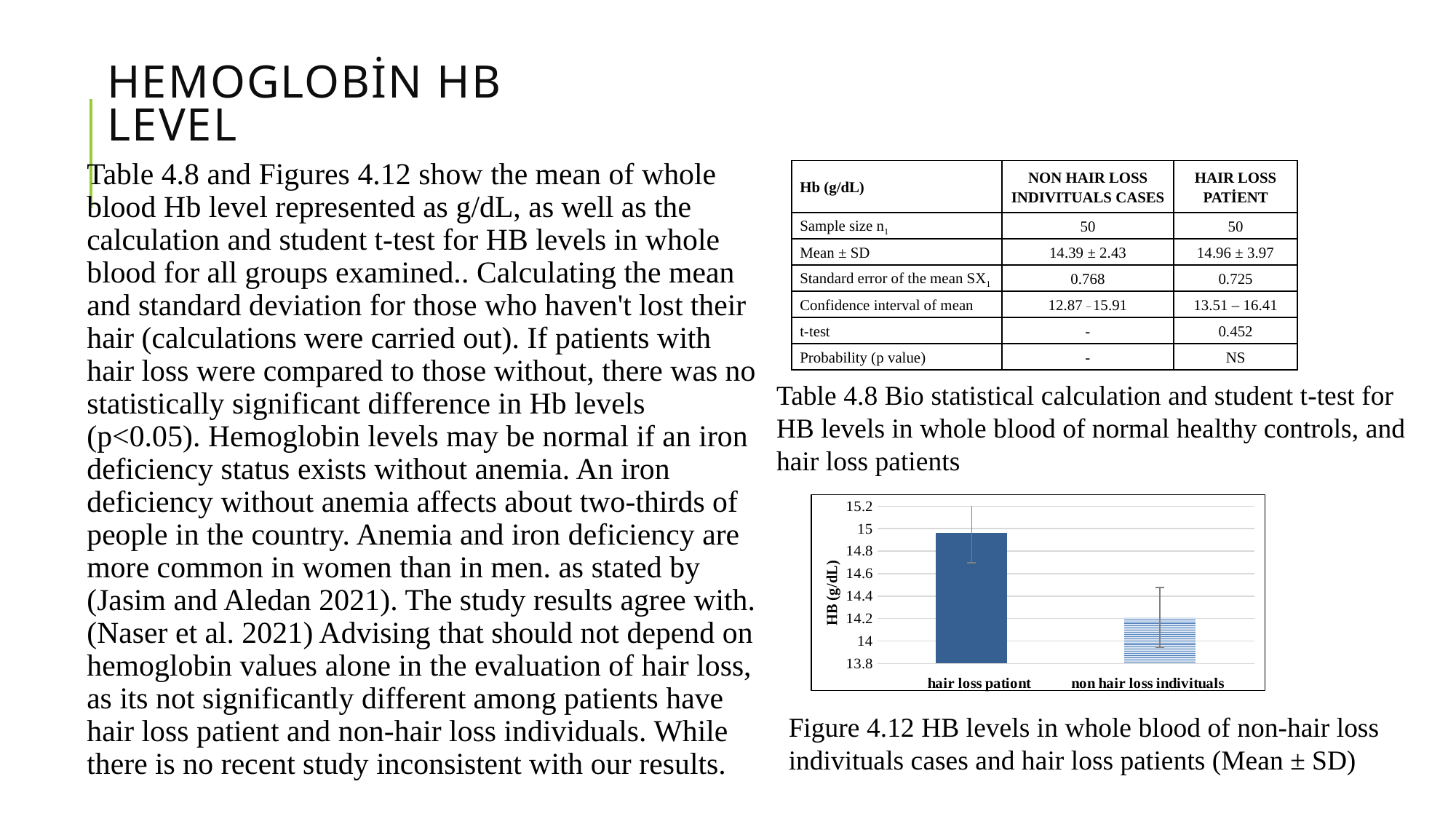
Which category has the highest bar in the chart? hair loss pationt Is the value for hair loss pationt greater or less than 14.8? greater What kind of chart is shown in Figure 4.12? bar chart Which bar is taller: hair loss pationt or non hair loss individuals? hair loss pationt How many bars are plotted in the chart? 2 Is the value for non hair loss individuals greater or less than 14.4? less Is the value for non hair loss individuals greater or less than 14? greater What is the lowest tick value shown on the vertical axis of the chart? 13.8 Which category has the lowest bar in the chart? non hair loss individuals What is the label on the vertical axis of the chart? HB (g/dL)